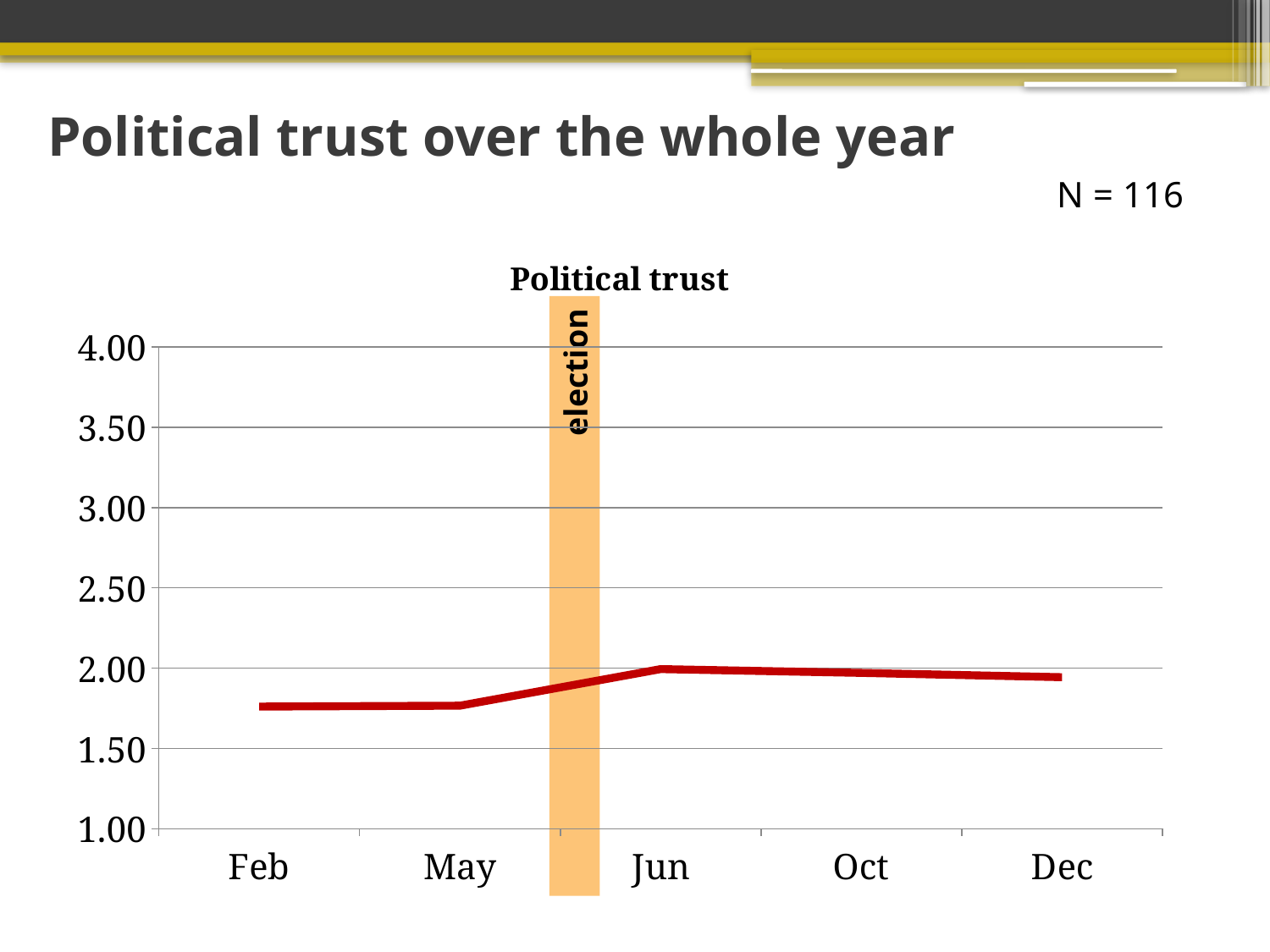
Is the value for May greater or less than 1.50? greater Between which two months on the x axis is the 'election' marker placed? May and Jun What is the highest value shown on the y axis of the chart? 4.00 Is the value for Dec greater or less than 1.50? greater What kind of chart is shown on the slide? line chart How many months are plotted on the x axis of the chart? 5 Does political trust rise or fall between May and Jun? rise Is the value for Oct greater or less than 2.50? less What is the title of the chart? Political trust Which is larger, the value for Jun or the value for Feb? Jun Which is larger, the value for May or the value for Dec? Dec